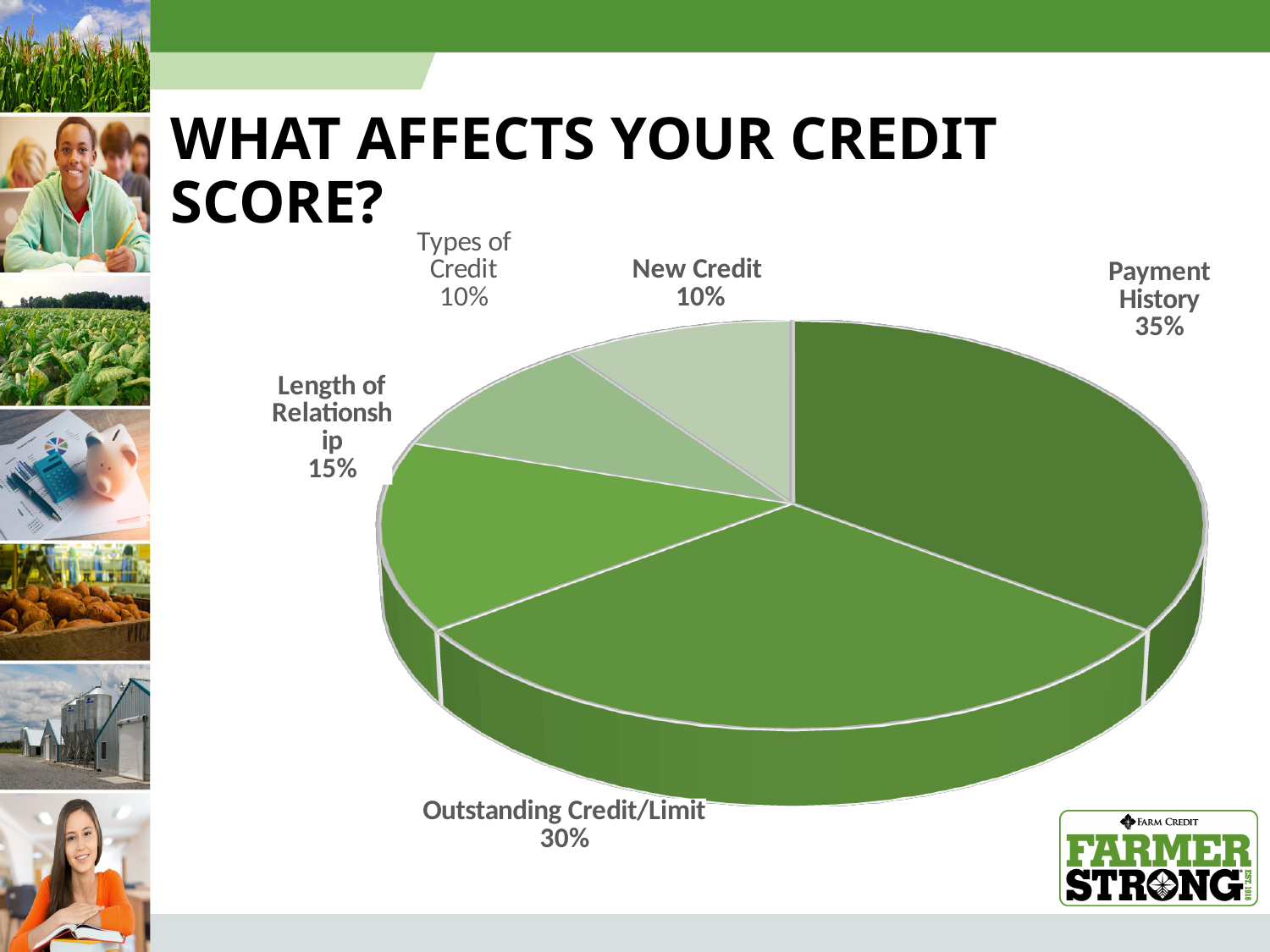
What percentage is shown for New Credit? 10% How many slices does the pie chart have? 5 What is the difference in percentage points between Payment History and Outstanding Credit/Limit? 5 Which is larger, Length of Relationship or Types of Credit? Length of Relationship What is the title of the slide containing the chart? WHAT AFFECTS YOUR CREDIT SCORE? What is the combined share of New Credit and Types of Credit? 20% What percentage of the credit score is attributed to Payment History? 35% What is the difference between Outstanding Credit/Limit and Length of Relationship? 15% Which factor has the largest share of the pie? Payment History What kind of chart is shown on the slide? Pie chart What percentage does Outstanding Credit/Limit account for? 30% What is the value shown for Length of Relationship? 15%